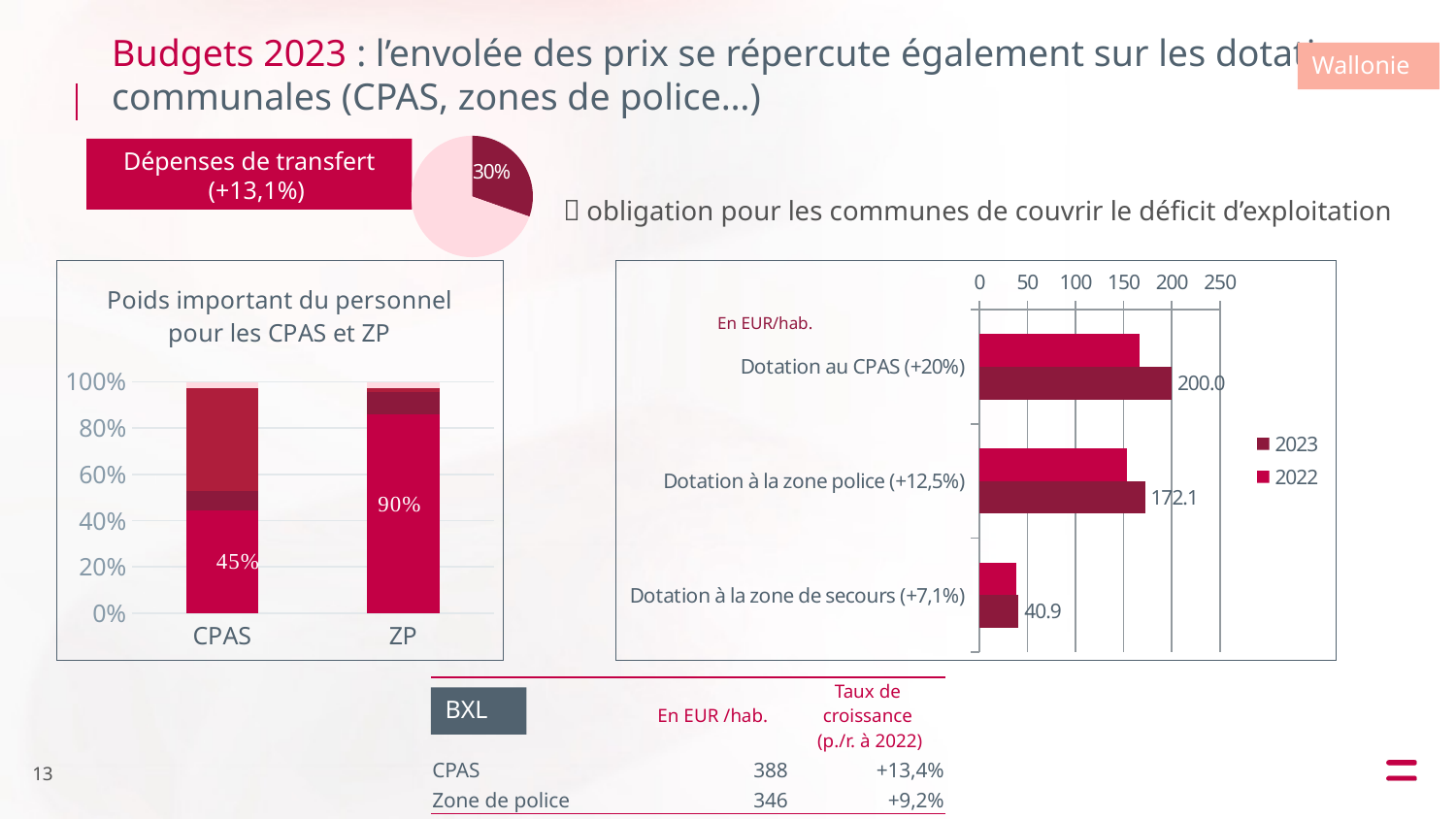
In the horizontal bar chart on the right (En EUR/hab.), what is the 2023 value for 'Dotation à la zone police (+12,5%)'? 172.1 In the horizontal bar chart on the right (En EUR/hab.), which category has the lowest 2023 value? Dotation à la zone de secours (+7,1%) In the horizontal bar chart on the right (En EUR/hab.), how many series does the legend list? 2 What kind of chart is the one titled 'Poids important du personnel pour les CPAS et ZP'? bar chart In the chart titled 'Poids important du personnel pour les CPAS et ZP', what is the difference between the labelled values for ZP and CPAS? 45% In the horizontal bar chart on the right (En EUR/hab.), what is the 2023 value for 'Dotation au CPAS (+20%)'? 200.0 In the horizontal bar chart on the right (En EUR/hab.), is the 2022 value for 'Dotation à la zone de secours' greater or less than 50? less In the horizontal bar chart on the right (En EUR/hab.), what is the 2023 value for 'Dotation à la zone de secours (+7,1%)'? 40.9 In the chart titled 'Poids important du personnel pour les CPAS et ZP', which category has the larger labelled value, CPAS or ZP? ZP In the horizontal bar chart on the right (En EUR/hab.), what is the difference between the 2023 values for 'Dotation au CPAS' and 'Dotation à la zone police'? 27.9 In the chart titled 'Poids important du personnel pour les CPAS et ZP', what is the labelled value for ZP? 90% In the chart titled 'Poids important du personnel pour les CPAS et ZP', what is the labelled value for CPAS? 45%